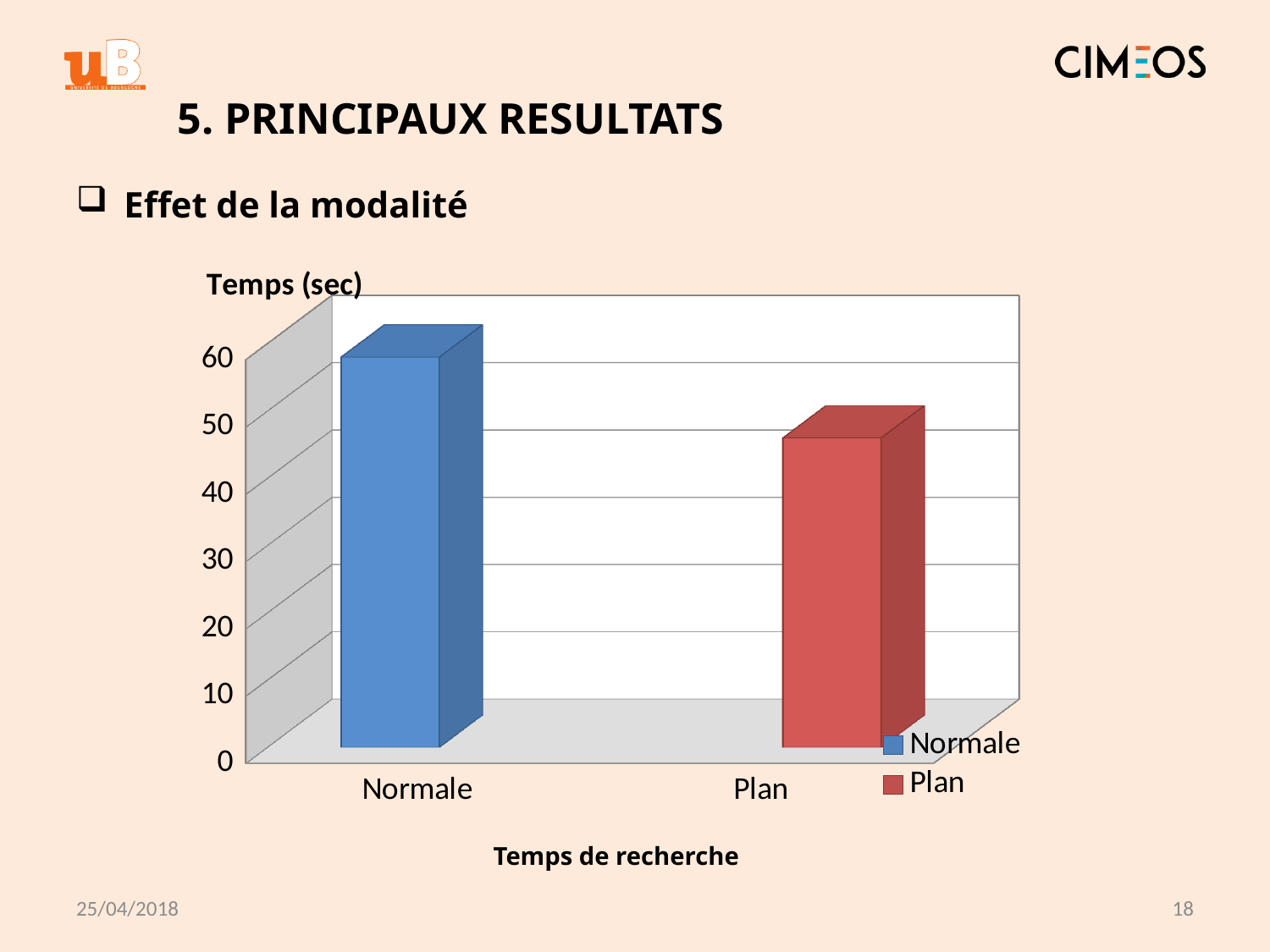
Which category has the highest search time in the chart? Normale Is the value for Normale greater or less than 50? greater Is the value for Plan greater or less than 60? less What is the title of the vertical axis of the chart? Temps (sec) How many series does the chart's legend list? 2 How many categories are plotted on the x axis of the chart? 2 Is the value for Normale greater or less than 30? greater What is the title of the horizontal axis of the chart? Temps de recherche Which category has the lowest search time in the chart? Plan Which has the larger value, Normale or Plan? Normale What kind of chart is shown on the slide? bar chart